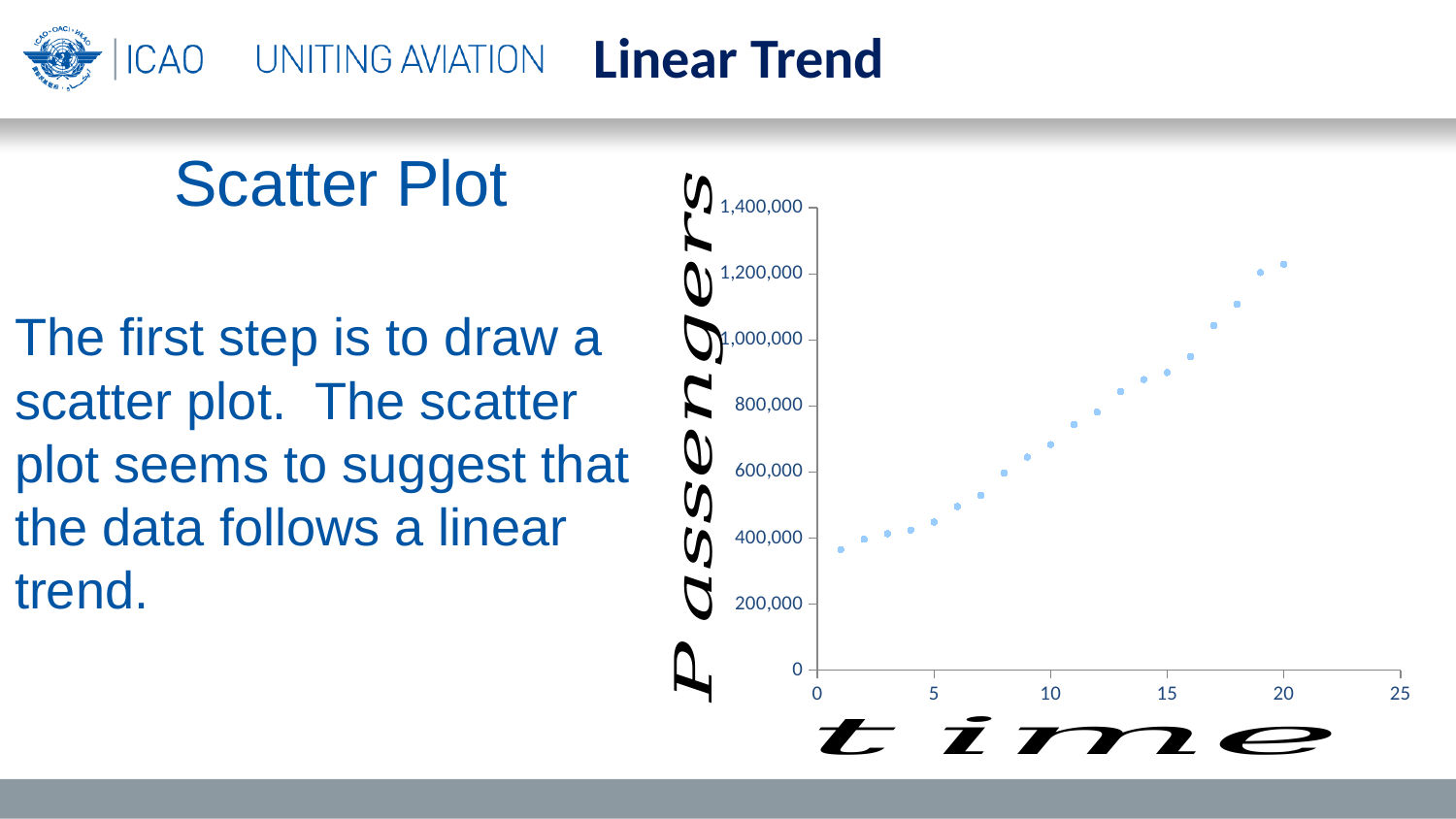
What is the label on the vertical axis of the chart? Passengers What kind of chart is shown on the slide? scatter plot What is the label on the horizontal axis of the chart? time Do the plotted passenger values rise or fall as time increases along the x axis? rise Is the passenger value at time 20 greater or less than 1,000,000? greater At which time value is the lowest passenger value plotted? 1 How many data points are plotted on the scatter plot? 20 Which has the larger passenger value, time 5 or time 15? time 15 Is the passenger value at time 1 greater or less than 400,000? less At which time value is the highest passenger value plotted? 20 Is the passenger value at time 10 greater or less than 800,000? less